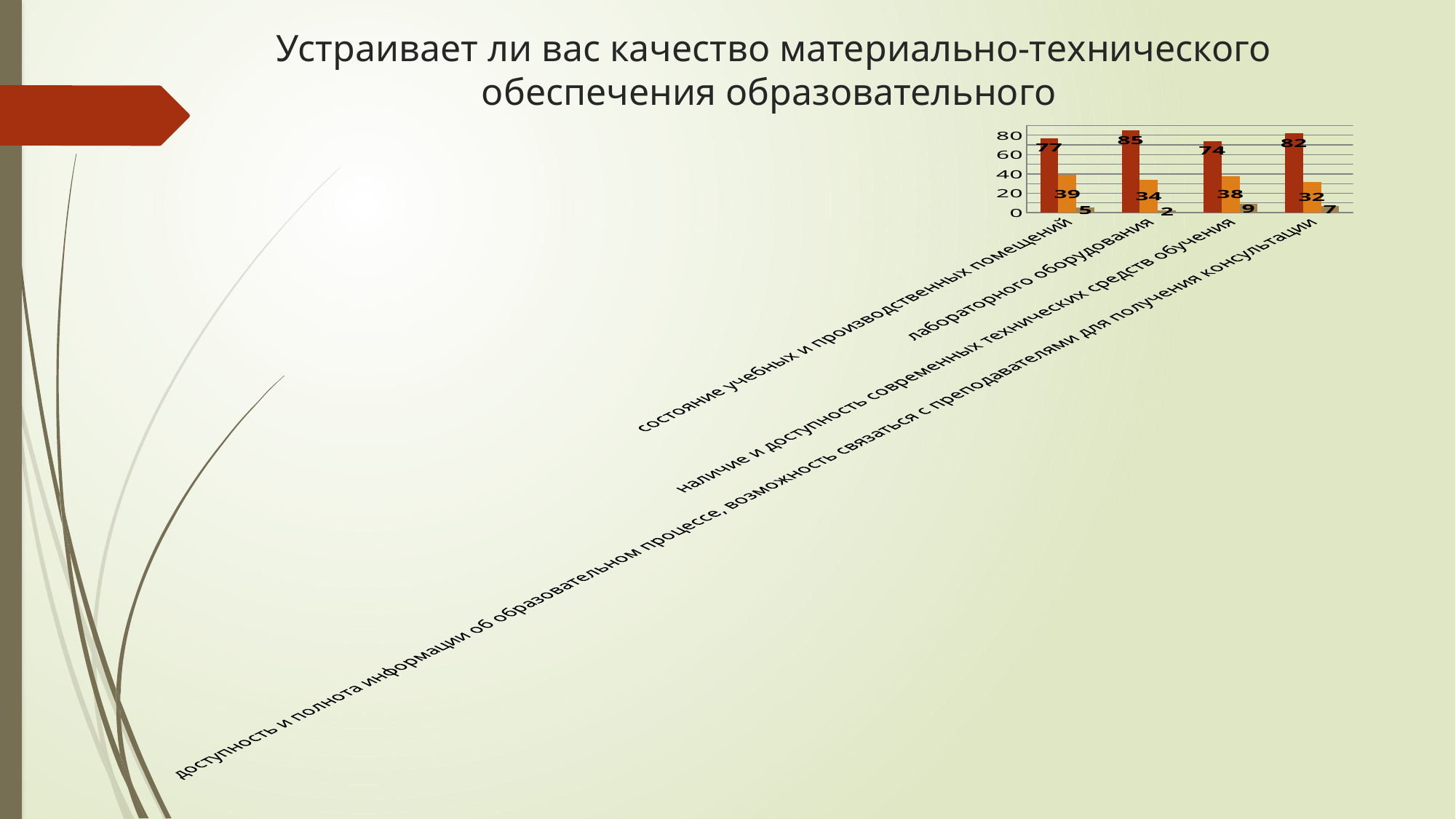
What is the difference between the dark red bar values for "лабораторного оборудования" and "наличие и доступность современных технических средств обучения"? 11 Which category has the lowest dark red bar? наличие и доступность современных технических средств обучения What is the value of the third (smallest) bar for "наличие и доступность современных технических средств обучения"? 9 Which category has the highest dark red bar? лабораторного оборудования What is the value of the smallest (third) bar for "лабораторного оборудования"? 2 How many categories are shown on the x axis of the chart? 4 What is the value of the dark red bar for "лабораторного оборудования"? 85 What is the value of the orange bar for "состояние учебных и производственных помещений"? 39 Is the dark red bar for "состояние учебных и производственных помещений" greater or less than 60? greater Which is larger: the orange bar for "состояние учебных и производственных помещений" or the orange bar for "лабораторного оборудования"? состояние учебных и производственных помещений What type of chart is shown on the slide? bar chart What is the value of the dark red bar for "наличие и доступность современных технических средств обучения"? 74